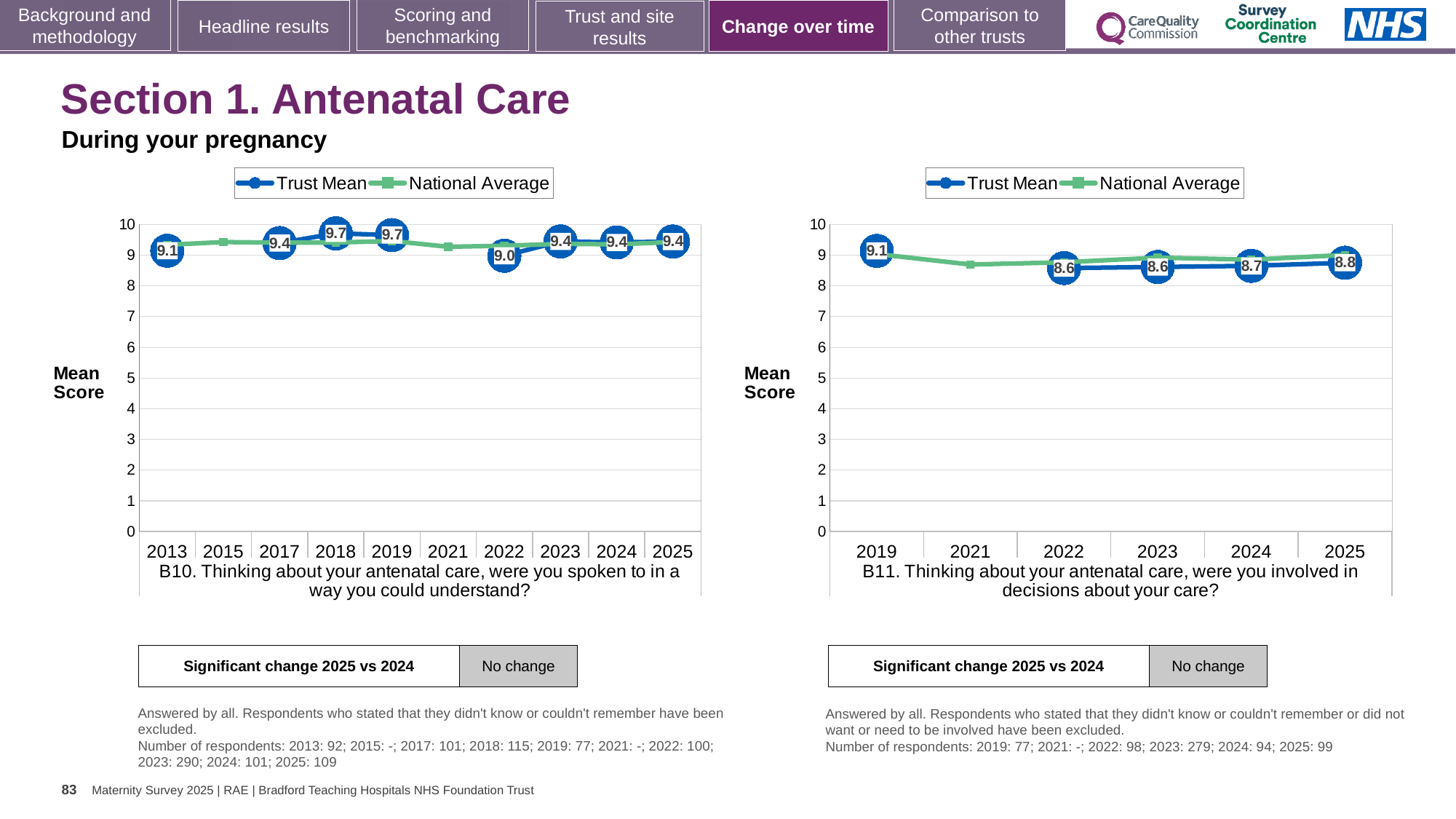
In the B11 chart on the right, what is the Trust Mean for 2025? 8.8 In the B10 chart on the left, which year has the lowest Trust Mean? 2022 In the B11 chart on the right, is the National Average for 2021 greater or less than 8? greater In the B10 chart on the left, is the Trust Mean higher in 2013 or in 2017? 2017 In the B11 chart on the right, what is the difference between the Trust Mean in 2019 and in 2022? 0.5 In the B11 chart on the right, how many years are shown on the x axis? 6 What type of chart is the B11 chart on the right? Line chart In the B10 chart on the left, what is the difference between the Trust Mean in 2019 and in 2022? 0.7 In the B10 chart on the left, what is the Trust Mean for 2022? 9.0 In the B11 chart on the right, which year has the highest Trust Mean? 2019 How many series does the legend of the B10 chart on the left list? 2 In the B10 chart on the left, what is the Trust Mean for 2018? 9.7